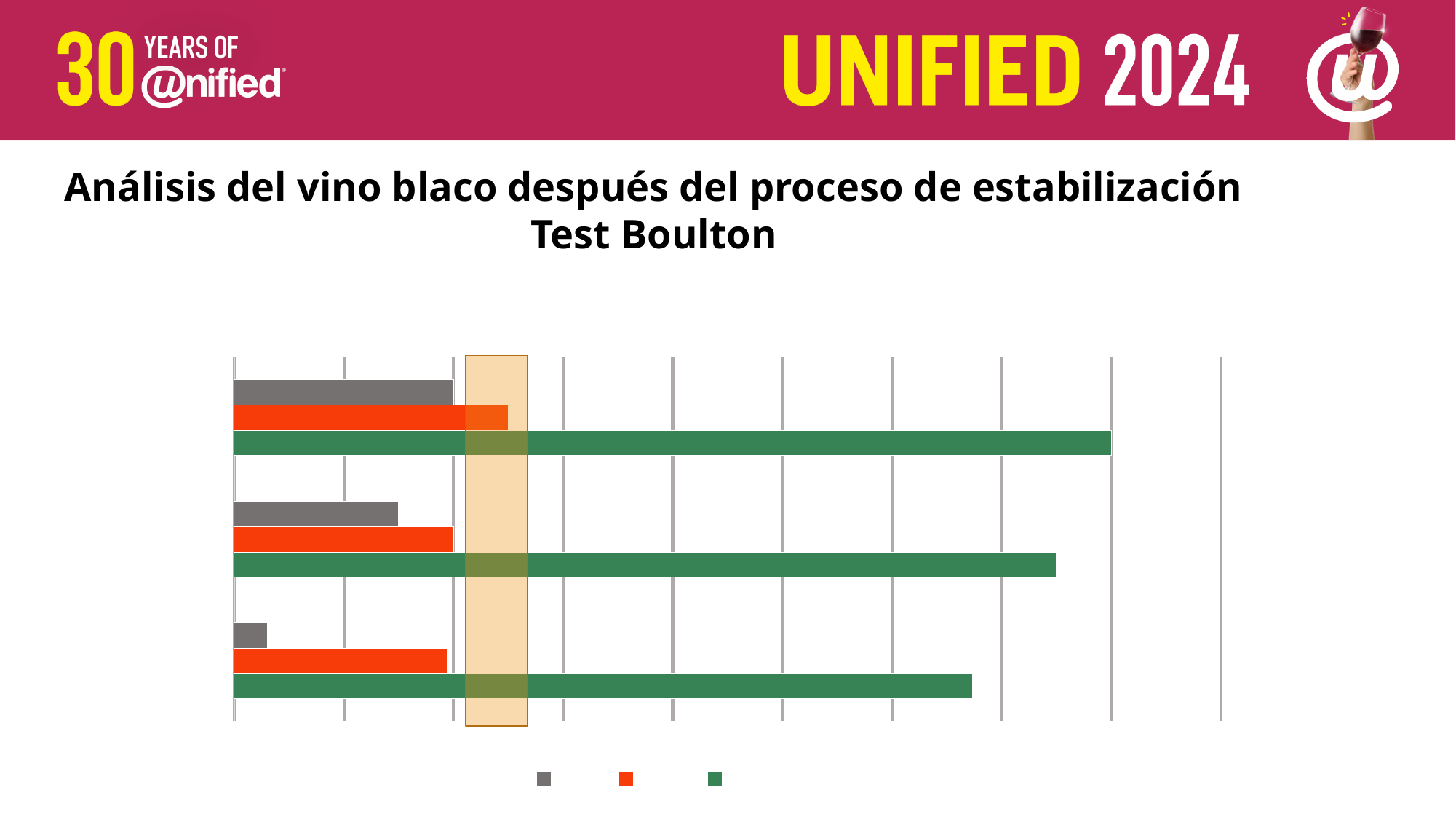
What colours are the three series in the legend? grey, orange and green Are the bars in the chart horizontal or vertical? horizontal What kind of chart is shown on the slide? bar chart How many series does the legend list? 3 Which colour series has the longest bar in every group of the chart? green How many groups of bars are plotted in the chart? 3